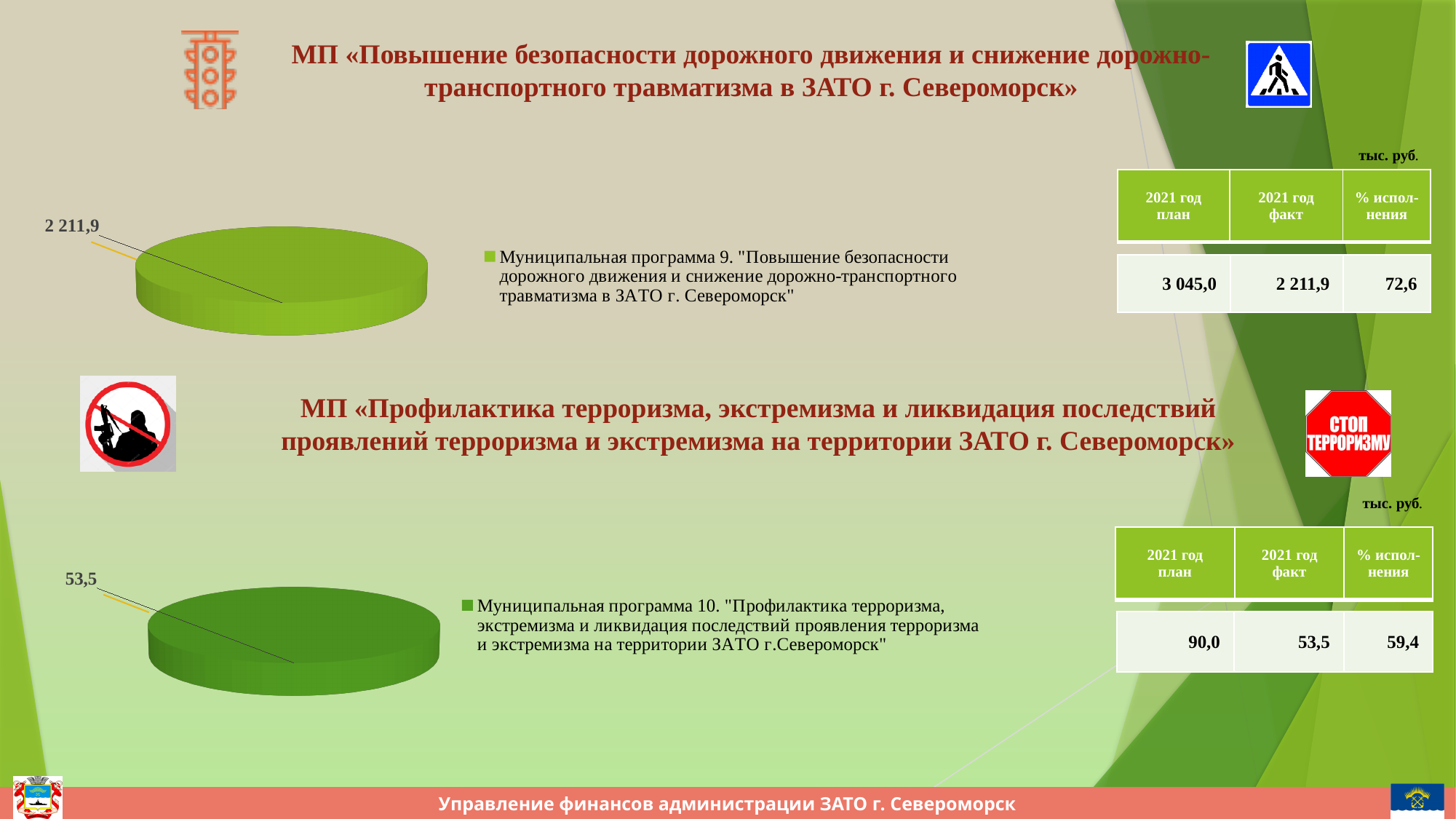
Which municipal programme number is named in the legend of the lower pie chart? Муниципальная программа 10 How many entries does the legend of the lower pie chart list? 1 In the lower pie chart, what value is shown by the data label? 53,5 In the upper pie chart, what value is shown by the data label? 2 211,9 Which municipal programme number is named in the legend of the upper pie chart? Муниципальная программа 9 How many entries does the legend of the upper pie chart list? 1 What kind of chart is the lower chart on the slide? pie chart How many slices does the lower pie chart have? 1 What kind of chart is the upper chart on the slide? pie chart What share of the upper pie chart does its single slice occupy? 100% How many slices does the upper pie chart have? 1 Which chart shows the larger labelled value, the upper pie chart or the lower pie chart? the upper pie chart